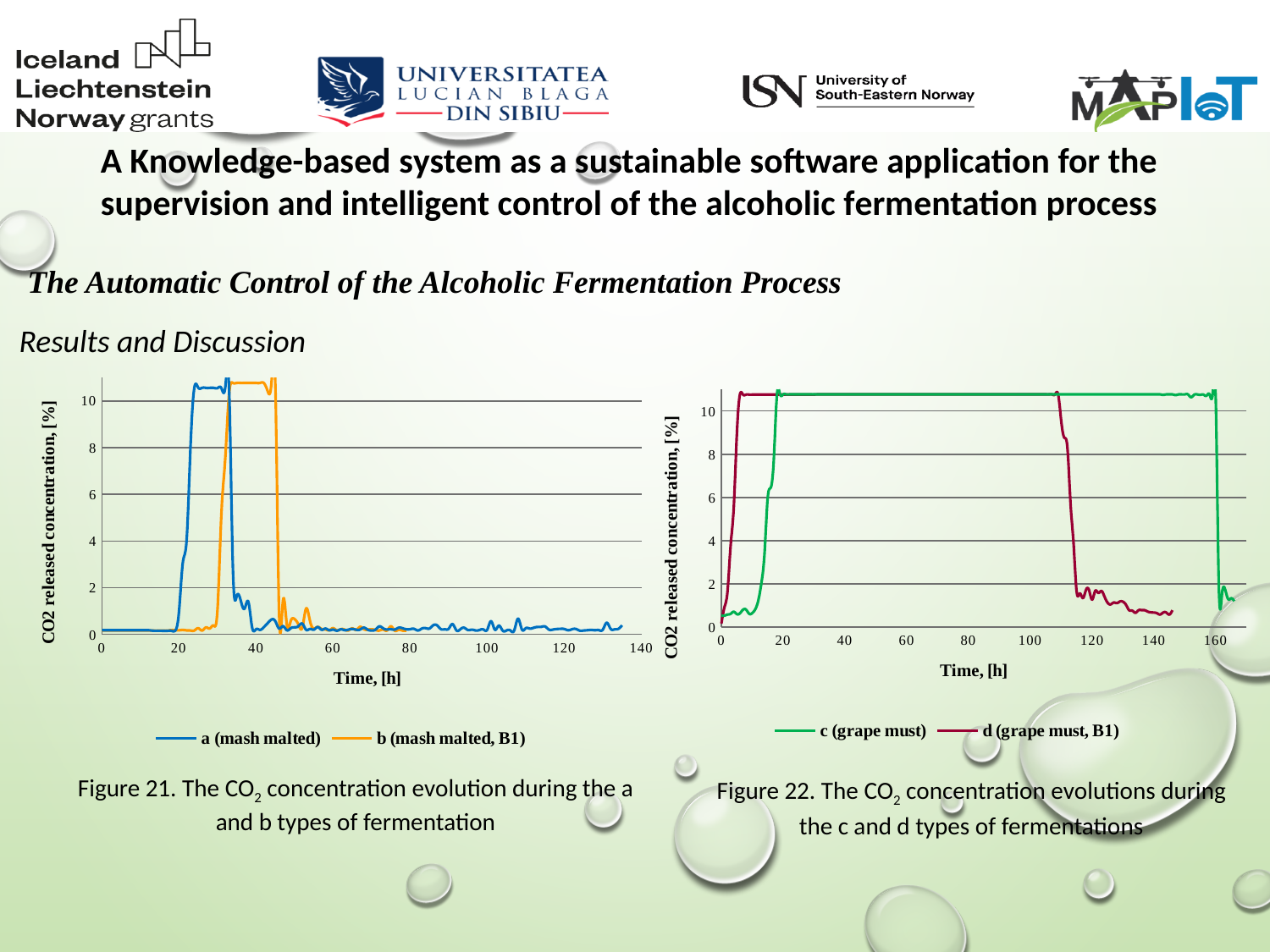
In Figure 22 (the right chart), does the d (grape must, B1) series rise or fall between time 110 h and 120 h? fall How many series does the legend of Figure 22 (the right chart) list? 2 In Figure 22 (the right chart), which series has the higher value at time 130 h, c (grape must) or d (grape must, B1)? c (grape must) In Figure 22 (the right chart), is the value of d (grape must, B1) at time 130 h greater or less than 4? less What is the y-axis label of Figure 22 (the right chart)? CO2 released concentration, [%] In Figure 21 (the left chart), does the a (mash malted) series rise or fall between time 20 h and 30 h? rise What kind of chart is Figure 21 (the left chart)? line chart In Figure 21 (the left chart), is the value of b (mash malted, B1) at time 40 h greater or less than 8? greater In Figure 21 (the left chart), which series has the higher value at time 40 h, a (mash malted) or b (mash malted, B1)? b (mash malted, B1) In Figure 21 (the left chart), is the value of a (mash malted) at time 60 h greater or less than 2? less In Figure 21 (the left chart), what are the two series named in the legend? a (mash malted) and b (mash malted, B1)